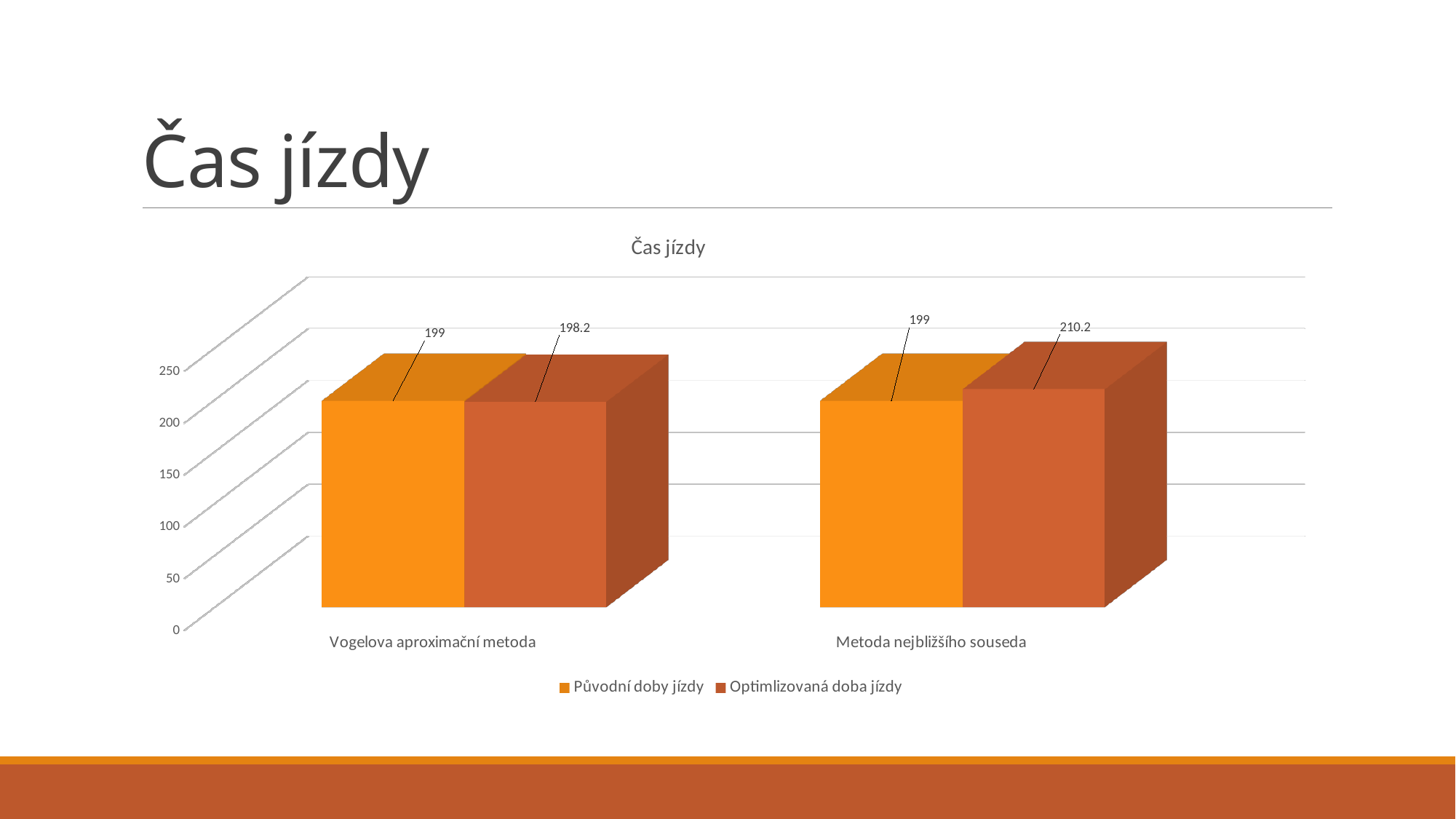
What is the title of the chart? Čas jízdy What is the value of Optimlizovaná doba jízdy for Vogelova aproximační metoda? 198.2 Which category has the highest Optimlizovaná doba jízdy value? Metoda nejbližšího souseda How many series does the legend list? 2 How many categories are shown on the x axis? 2 What is the value of Původní doby jízdy for Vogelova aproximační metoda? 199 What is the value of Optimlizovaná doba jízdy for Metoda nejbližšího souseda? 210.2 What is the value of Původní doby jízdy for Metoda nejbližšího souseda? 199 What is the difference between the Optimlizovaná doba jízdy values for Metoda nejbližšího souseda and Vogelova aproximační metoda? 12 Which category has the lowest Optimlizovaná doba jízdy value? Vogelova aproximační metoda What kind of chart is shown on the slide? Bar chart For Metoda nejbližšího souseda, which is larger: Původní doby jízdy or Optimlizovaná doba jízdy? Optimlizovaná doba jízdy